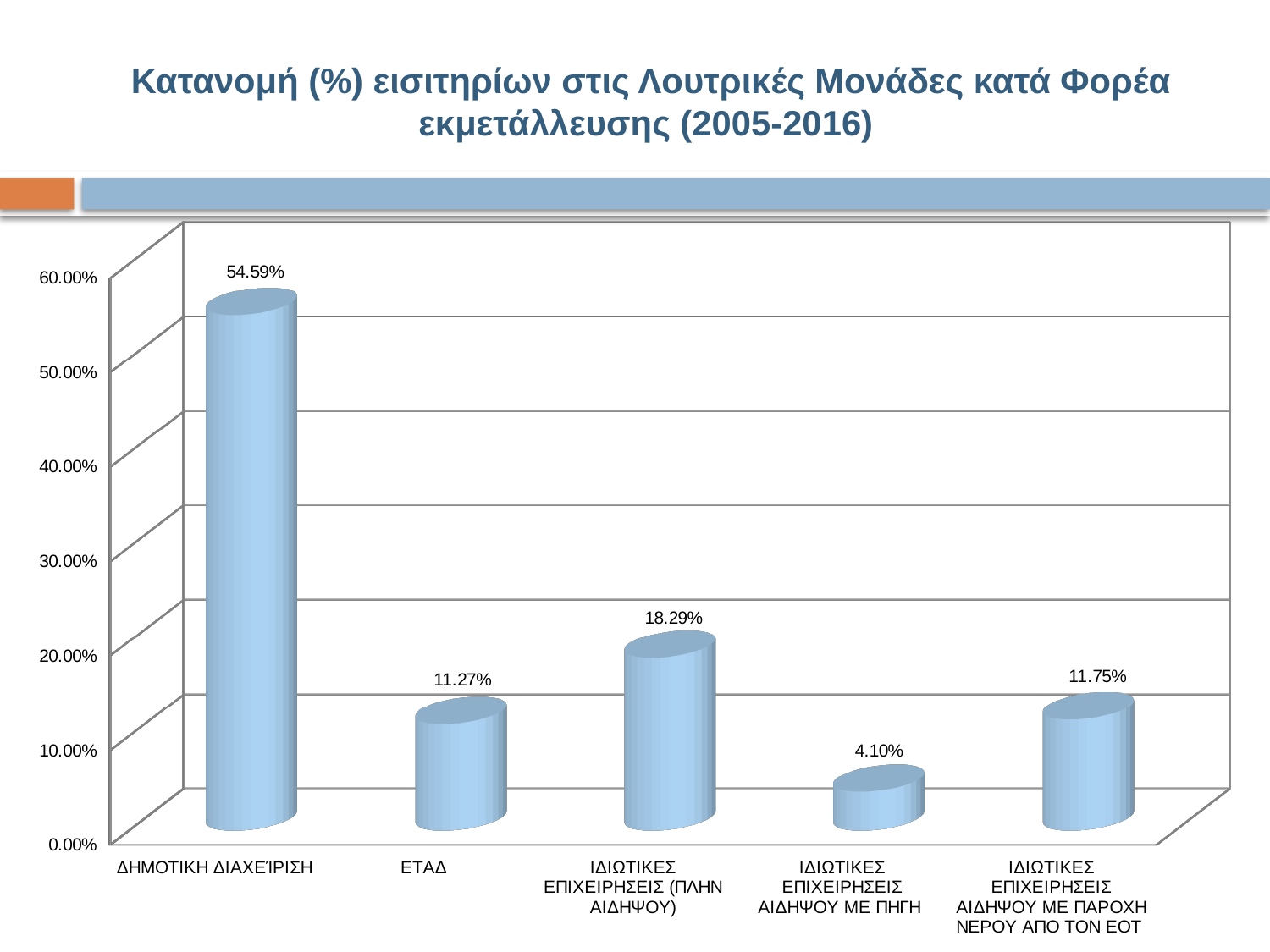
How many categories are shown in the chart? 5 What is the difference between the values for ΙΔΙΩΤΙΚΕΣ ΕΠΙΧΕΙΡΗΣΕΙΣ (ΠΛΗΝ ΑΙΔΗΨΟΥ) and ΙΔΙΩΤΙΚΕΣ ΕΠΙΧΕΙΡΗΣΕΙΣ ΑΙΔΗΨΟΥ ΜΕ ΠΗΓΗ? 14.19% What is the value for ΙΔΙΩΤΙΚΕΣ ΕΠΙΧΕΙΡΗΣΕΙΣ ΑΙΔΗΨΟΥ ΜΕ ΠΑΡΟΧΗ ΝΕΡΟΥ ΑΠΟ ΤΟΝ ΕΟΤ? 11.75% What is the value for ΕΤΑΔ? 11.27% What is the value for ΙΔΙΩΤΙΚΕΣ ΕΠΙΧΕΙΡΗΣΕΙΣ ΑΙΔΗΨΟΥ ΜΕ ΠΗΓΗ? 4.10% Which category has the highest value? ΔΗΜΟΤΙΚΗ ΔΙΑΧΕΊΡΙΣΗ Which category has the lowest value? ΙΔΙΩΤΙΚΕΣ ΕΠΙΧΕΙΡΗΣΕΙΣ ΑΙΔΗΨΟΥ ΜΕ ΠΗΓΗ What is the value for ΙΔΙΩΤΙΚΕΣ ΕΠΙΧΕΙΡΗΣΕΙΣ (ΠΛΗΝ ΑΙΔΗΨΟΥ)? 18.29% What is the difference between the values for ΔΗΜΟΤΙΚΗ ΔΙΑΧΕΊΡΙΣΗ and ΙΔΙΩΤΙΚΕΣ ΕΠΙΧΕΙΡΗΣΕΙΣ (ΠΛΗΝ ΑΙΔΗΨΟΥ)? 36.30% Which is larger, the value for ΕΤΑΔ or the value for ΙΔΙΩΤΙΚΕΣ ΕΠΙΧΕΙΡΗΣΕΙΣ ΑΙΔΗΨΟΥ ΜΕ ΠΑΡΟΧΗ ΝΕΡΟΥ ΑΠΟ ΤΟΝ ΕΟΤ? ΙΔΙΩΤΙΚΕΣ ΕΠΙΧΕΙΡΗΣΕΙΣ ΑΙΔΗΨΟΥ ΜΕ ΠΑΡΟΧΗ ΝΕΡΟΥ ΑΠΟ ΤΟΝ ΕΟΤ What is the value for ΔΗΜΟΤΙΚΗ ΔΙΑΧΕΊΡΙΣΗ? 54.59% What kind of chart is shown on the slide? Bar chart